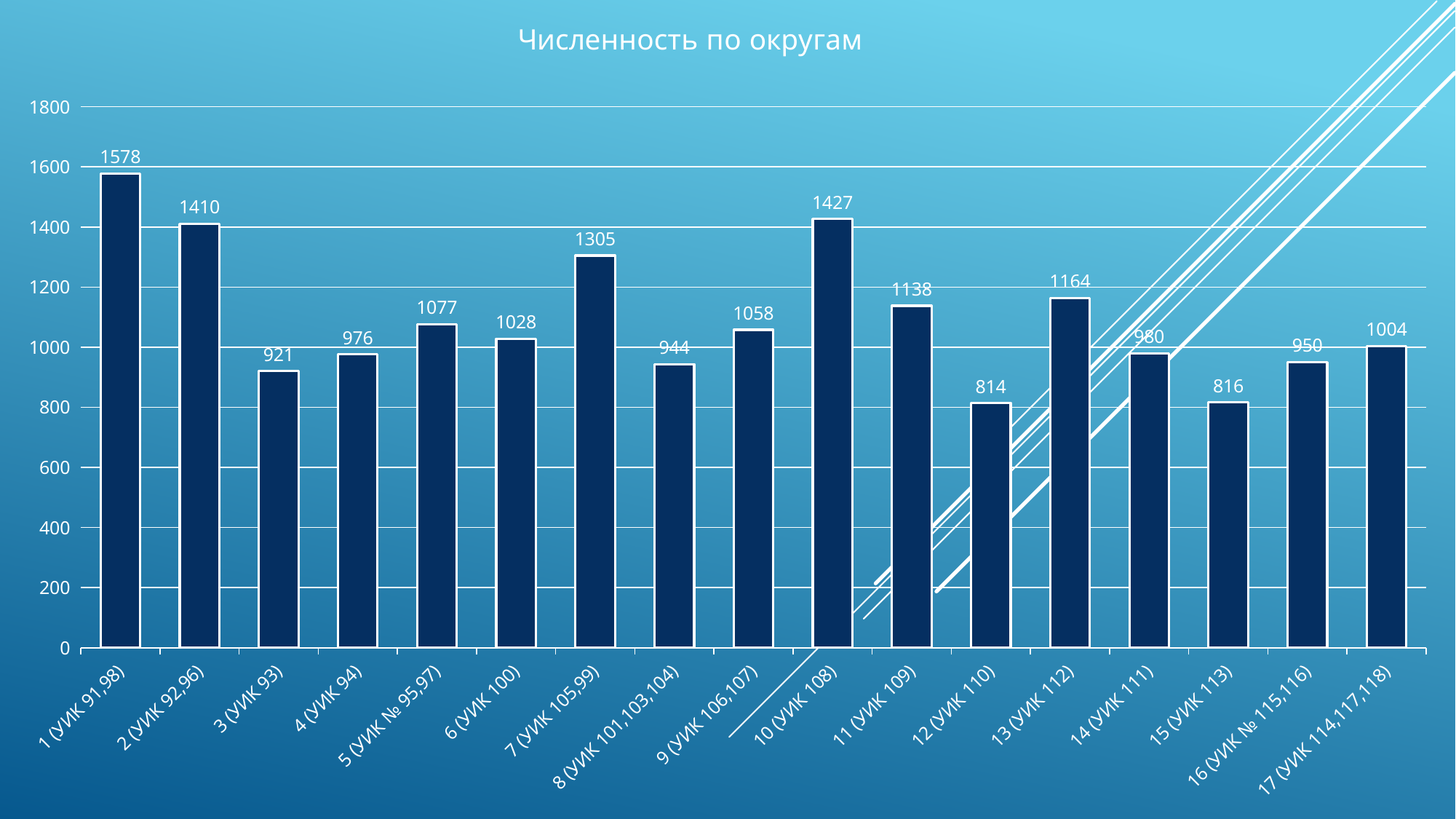
What is the difference between the values for 2 (УИК 92,96) and 3 (УИК 93)? 489 Is the value for 13 (УИК 112) greater or less than 1000? greater What is the value for 1 (УИК 91,98)? 1578 What is the value for 17 (УИК 114,117,118)? 1004 Which district has the lowest value? 12 (УИК 110) What is the difference between the values for 10 (УИК 108) and 12 (УИК 110)? 613 What is the title of the chart? Численность по округам Which district has the highest value? 1 (УИК 91,98) What kind of chart is shown on the slide? bar chart How many categories (districts) are plotted on the chart? 17 Which is larger, the value for 7 (УИК 105,99) or the value for 11 (УИК 109)? 7 (УИК 105,99) What is the value for 10 (УИК 108)? 1427